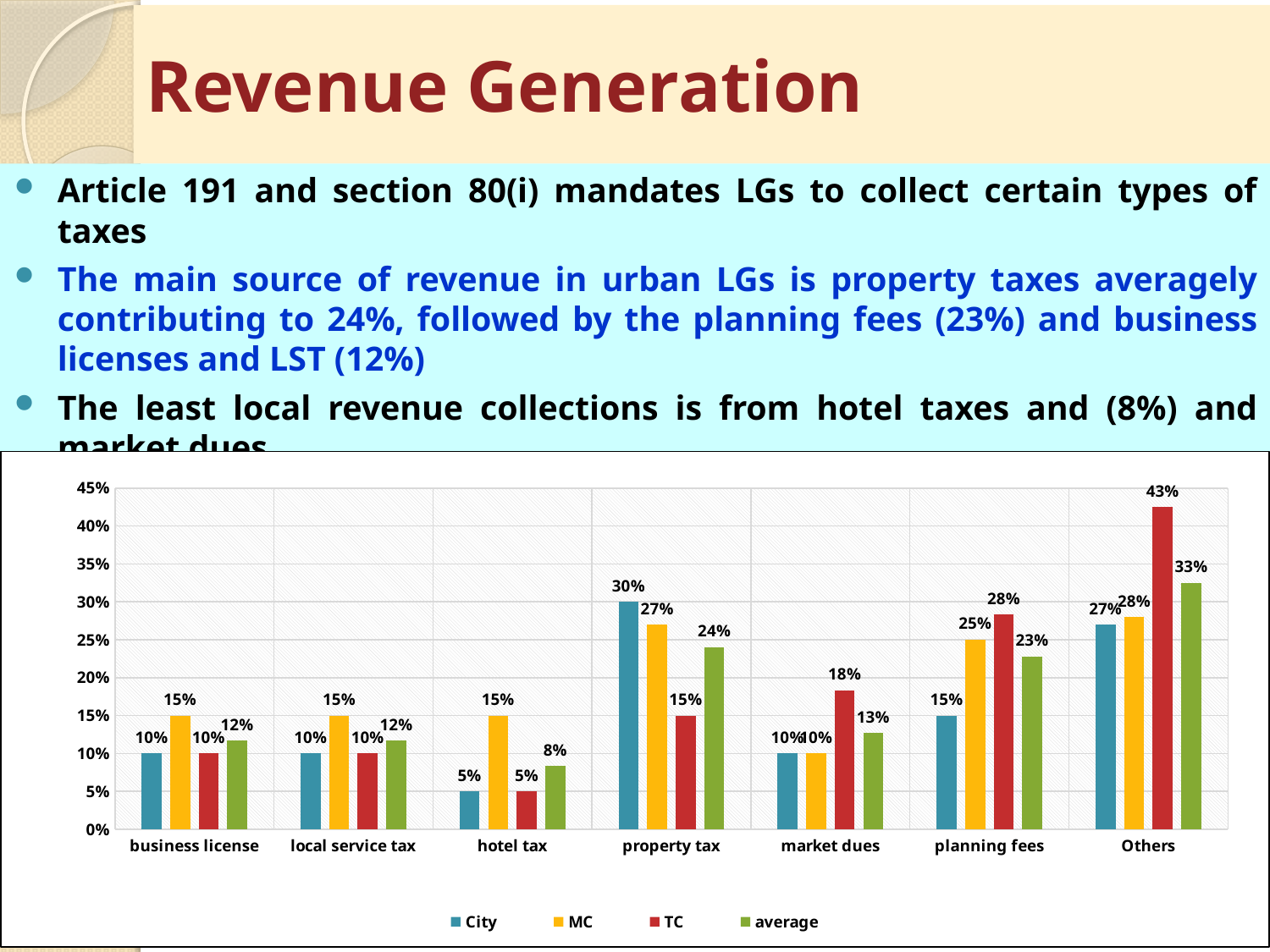
How many categories are shown on the x axis? 7 What is the average value for hotel tax? 8% Which category has the lowest average value? hotel tax What is the difference between the TC value and the City value for Others? 16% What kind of chart is shown on the slide? bar chart What is the MC value for planning fees? 25% What is the TC value for Others? 43% Which series is shown in red in the legend? TC How many series does the legend list? 4 Which is larger for market dues, the TC value or the MC value? TC What is the City value for property tax? 30% Which category has the highest TC value? Others